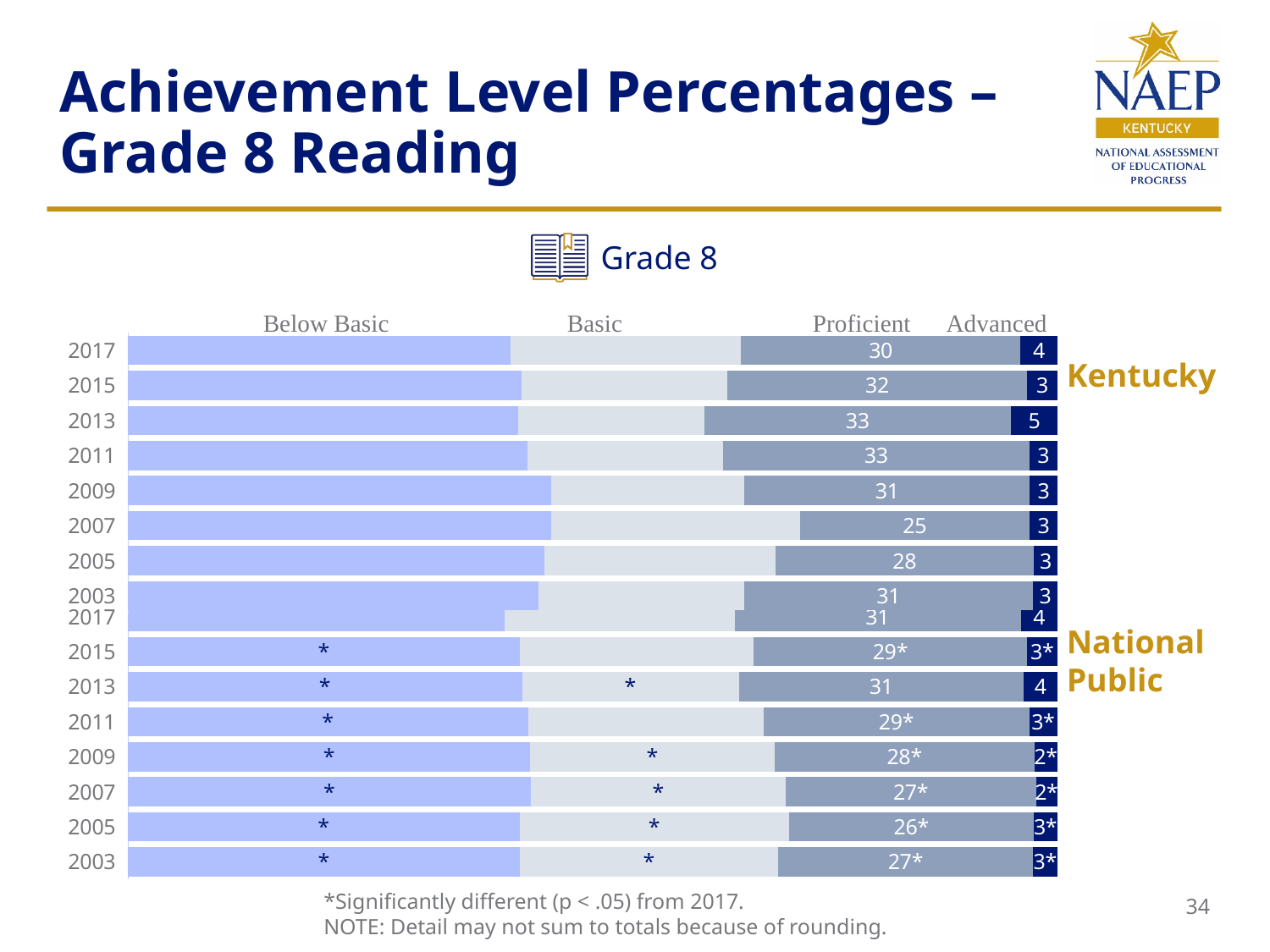
In which year was Kentucky's Proficient percentage lowest? 2007 What is the difference between Kentucky's Proficient percentage in 2013 and in 2007? 8 What type of chart is shown on the slide? Stacked bar chart What is the Advanced percentage for Kentucky in 2013? 5 What is the Proficient value shown for National Public in 2015? 29* How many years are shown for Kentucky in the chart? 8 What is the Advanced value shown for National Public in 2009? 2* What is the Proficient percentage for Kentucky in 2017? 30 In which year was Kentucky's Advanced percentage highest? 2013 How many achievement levels are shown across the top of the chart? 4 What is the Proficient percentage for Kentucky in 2007? 25 Which is larger, Kentucky's Proficient percentage in 2015 or National Public's Proficient percentage in 2015? Kentucky (32)